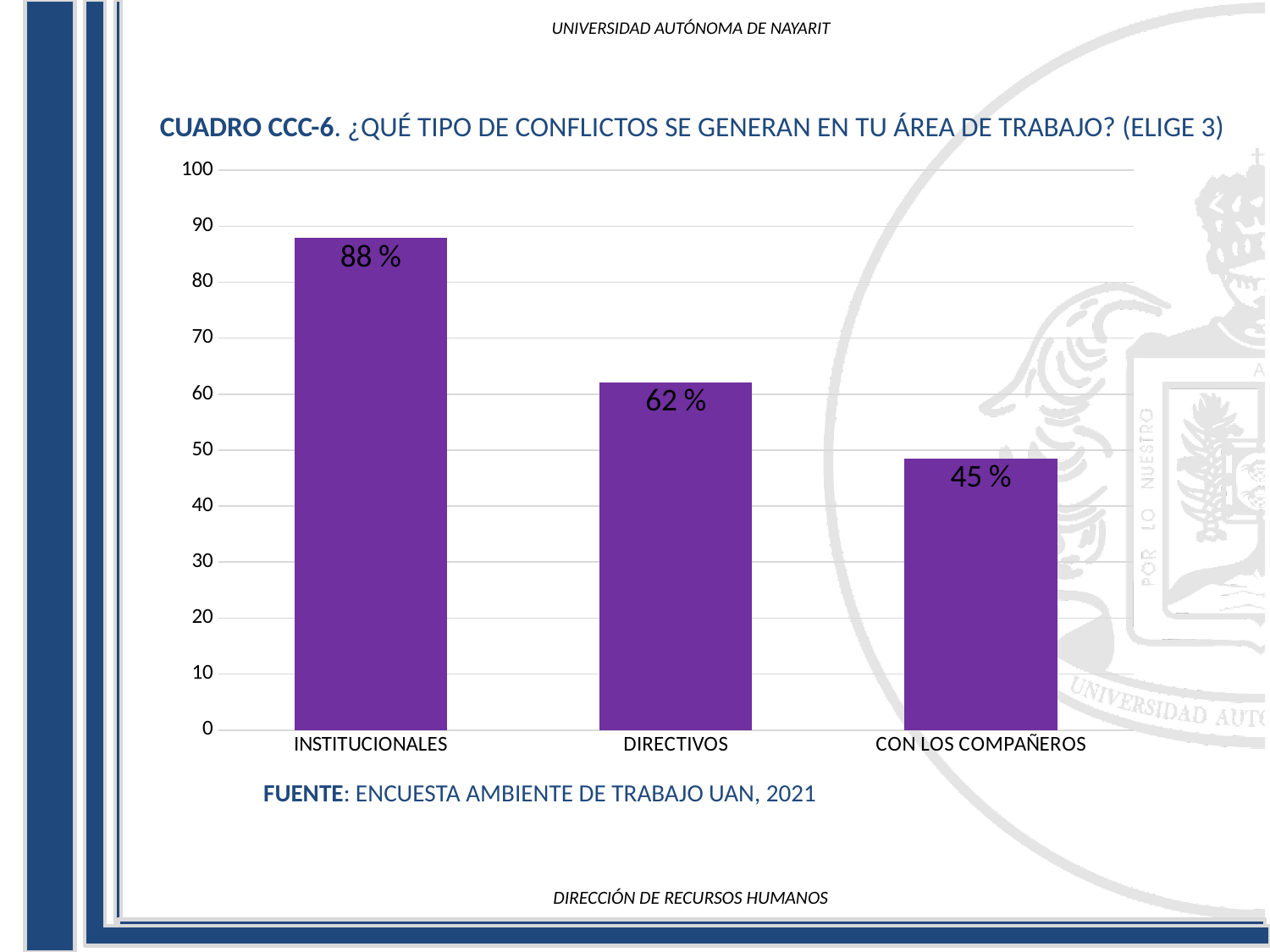
Is the value for DIRECTIVOS greater or less than 50? greater What is the value for INSTITUCIONALES? 88 % How many categories are shown on the x axis? 3 What kind of chart is shown on the slide? bar chart What is the difference between the values for DIRECTIVOS and CON LOS COMPAÑEROS? 17 % Which category has the lowest value? CON LOS COMPAÑEROS What is the value for DIRECTIVOS? 62 % Which is larger, the value for DIRECTIVOS or the value for CON LOS COMPAÑEROS? DIRECTIVOS What source is cited below the chart? ENCUESTA AMBIENTE DE TRABAJO UAN, 2021 What is the difference between the values for INSTITUCIONALES and DIRECTIVOS? 26 % What is the value for CON LOS COMPAÑEROS? 45 % Which category has the highest value? INSTITUCIONALES